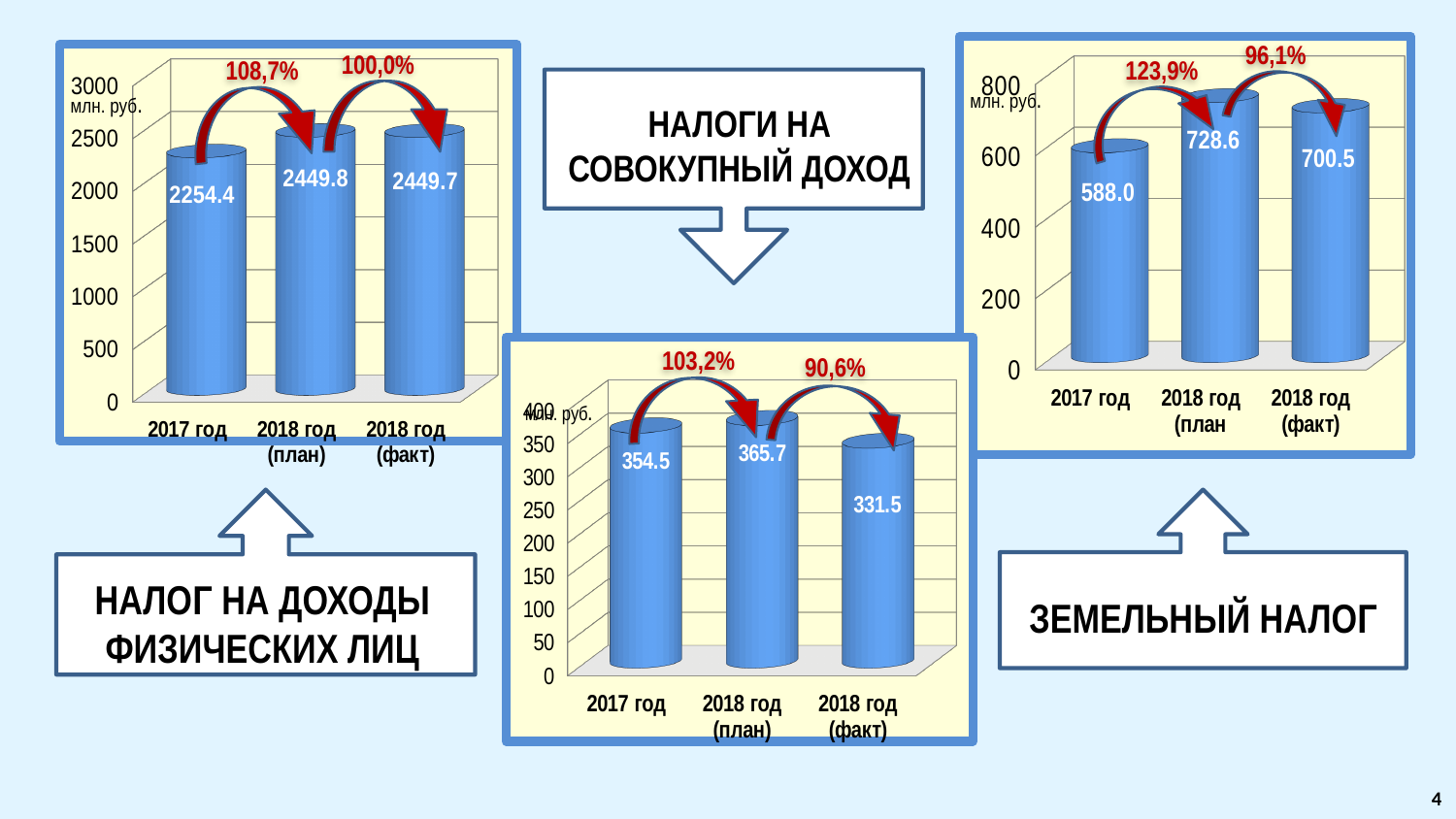
What kind of chart is the left chart (НАЛОГ НА ДОХОДЫ ФИЗИЧЕСКИХ ЛИЦ)? bar chart In the left chart (НАЛОГ НА ДОХОДЫ ФИЗИЧЕСКИХ ЛИЦ), what is the value for 2017 год? 2254.4 In the right chart (ЗЕМЕЛЬНЫЙ НАЛОГ), is the value for 2017 год greater or less than 400? greater In the right chart (ЗЕМЕЛЬНЫЙ НАЛОГ), which category has the lowest value? 2017 год In the right chart (ЗЕМЕЛЬНЫЙ НАЛОГ), what is the value for 2018 год (план)? 728.6 In the left chart (НАЛОГ НА ДОХОДЫ ФИЗИЧЕСКИХ ЛИЦ), which category has the lowest value? 2017 год In the middle chart (НАЛОГИ НА СОВОКУПНЫЙ ДОХОД), which category has the highest value? 2018 год (план) In the left chart (НАЛОГ НА ДОХОДЫ ФИЗИЧЕСКИХ ЛИЦ), what is the difference between the 2018 год (план) value and the 2017 год value? 195.4 In the middle chart (НАЛОГИ НА СОВОКУПНЫЙ ДОХОД), what is the value for 2018 год (факт)? 331.5 How many categories are shown on the x axis of the middle chart (НАЛОГИ НА СОВОКУПНЫЙ ДОХОД)? 3 In the middle chart (НАЛОГИ НА СОВОКУПНЫЙ ДОХОД), which is larger: the value for 2017 год or the value for 2018 год (факт)? 2017 год In the right chart (ЗЕМЕЛЬНЫЙ НАЛОГ), what is the difference between the 2018 год (план) value and the 2018 год (факт) value? 28.1